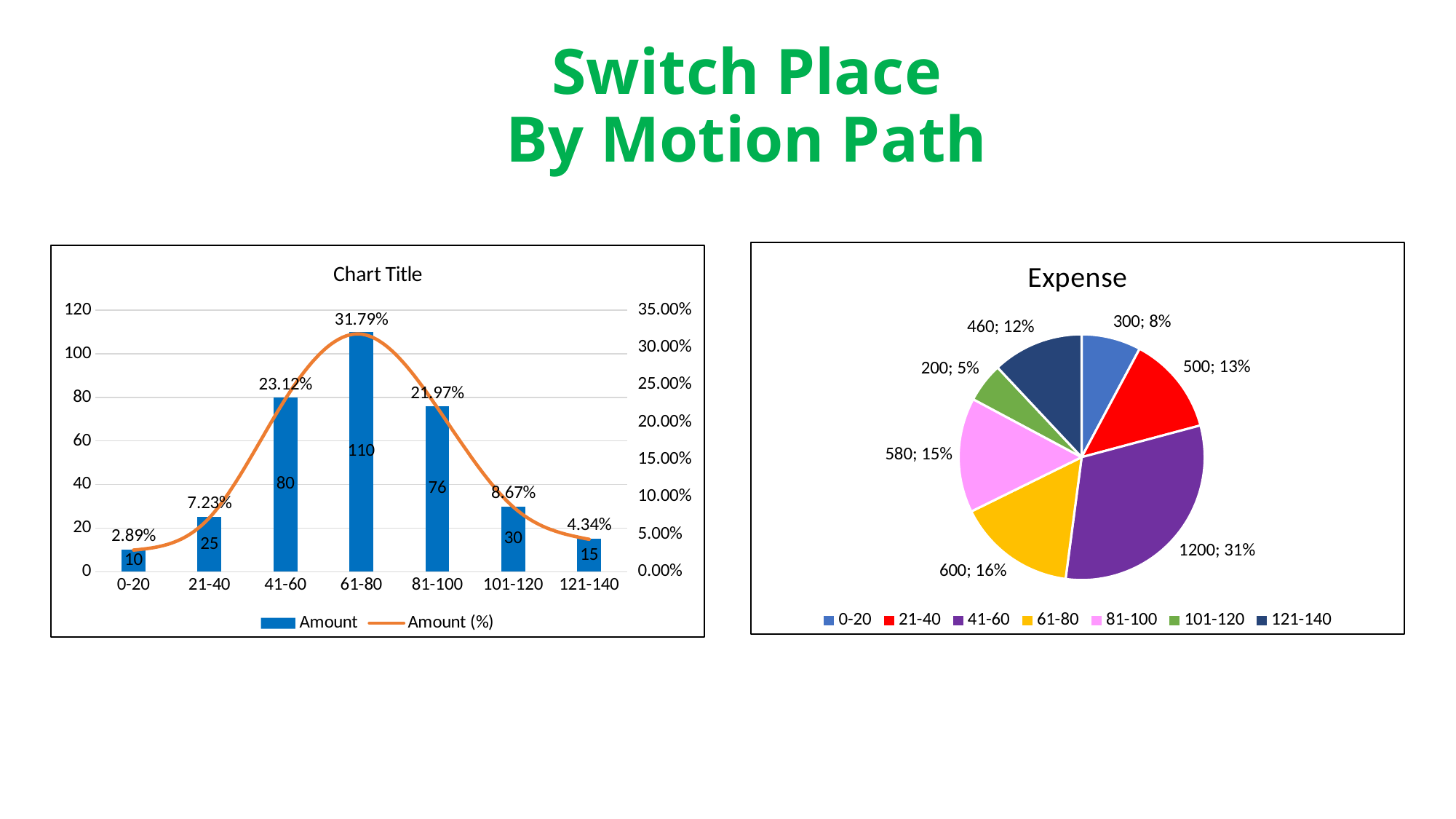
In the chart titled "Chart Title", how many series does the legend list? 2 In the chart titled "Chart Title", which is larger, the Amount for 21-40 or the Amount for 101-120? 101-120 In the Expense chart, which category has the smallest slice? 101-120 In the Expense chart, what value is shown for the 41-60 slice? 1200 In the chart titled "Chart Title", which category has the lowest Amount? 0-20 What type of chart is the Expense chart? Pie chart In the chart titled "Chart Title", what is the Amount for the 61-80 category? 110 In the chart titled "Chart Title", what is the Amount (%) value for the 41-60 category? 23.12% In the chart titled "Chart Title", how many categories are shown on the x axis? 7 In the chart titled "Chart Title", what is the difference in Amount between the 41-60 and 81-100 categories? 4 In the Expense chart, what share of the pie does the 81-100 slice represent? 15% In the Expense chart, what is the difference between the values for 61-80 and 121-140? 140